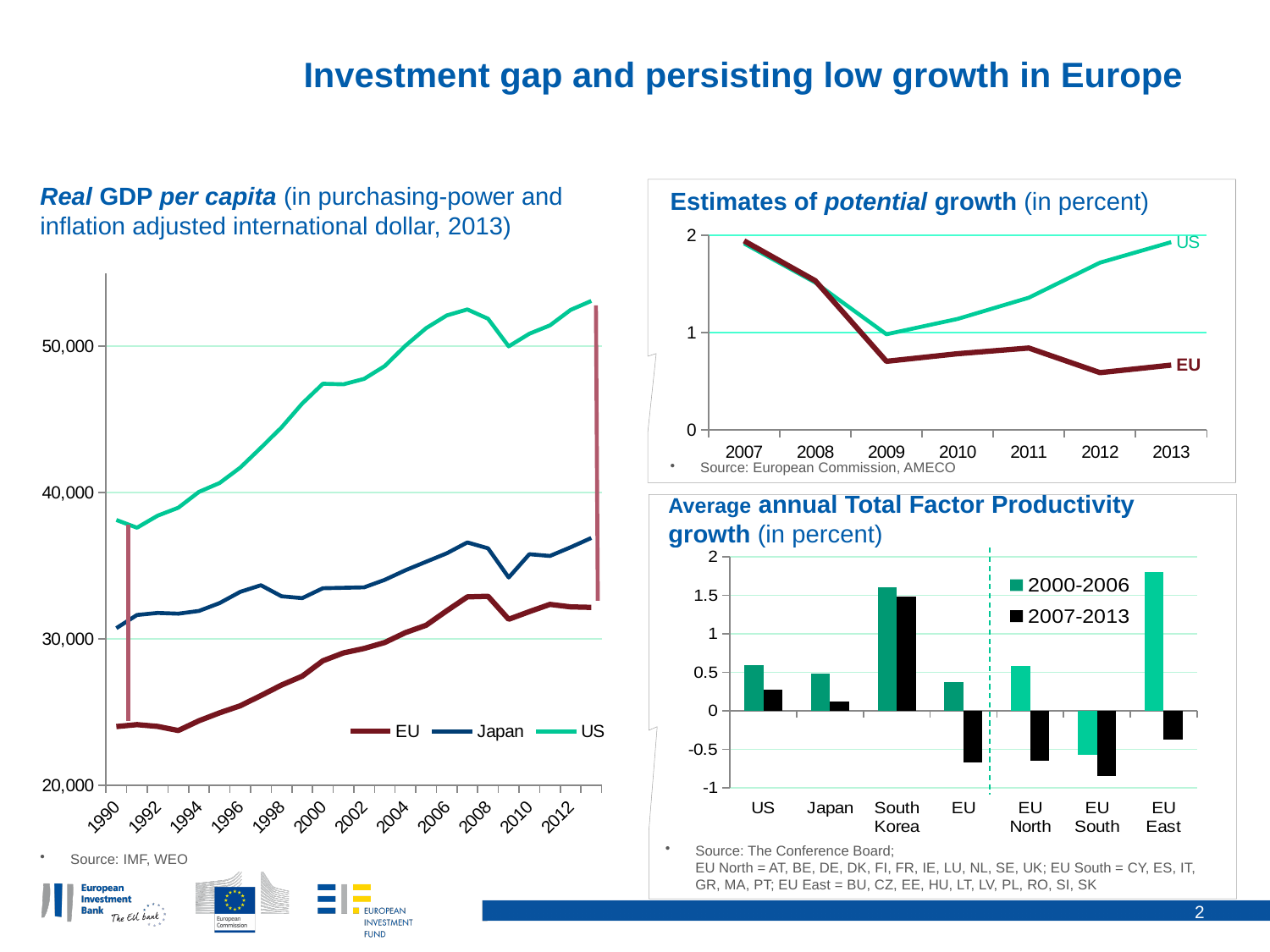
In the 'Average annual Total Factor Productivity growth' chart, is the value for the EU in 2007-2013 greater or less than 0? less In the 'Real GDP per capita' chart, which series has the lowest value in 1990? EU In the 'Real GDP per capita' chart, is the value for the EU in 1990 greater or less than 30,000? less In the 'Estimates of potential growth' chart, which series is higher in 2013, US or EU? US How many series does the legend of the 'Real GDP per capita' chart list? 3 In the 'Real GDP per capita' chart, which series has the highest value in 2013? US In the 'Average annual Total Factor Productivity growth' chart, which category has the lowest value for 2007-2013? EU South In the 'Average annual Total Factor Productivity growth' chart, which category has the highest value for 2000-2006? EU East What type of chart is the 'Average annual Total Factor Productivity growth' chart? bar chart In the 'Real GDP per capita' chart, is the value for the US in 2013 greater or less than 50,000? greater How many years are shown on the x axis of the 'Estimates of potential growth' chart? 7